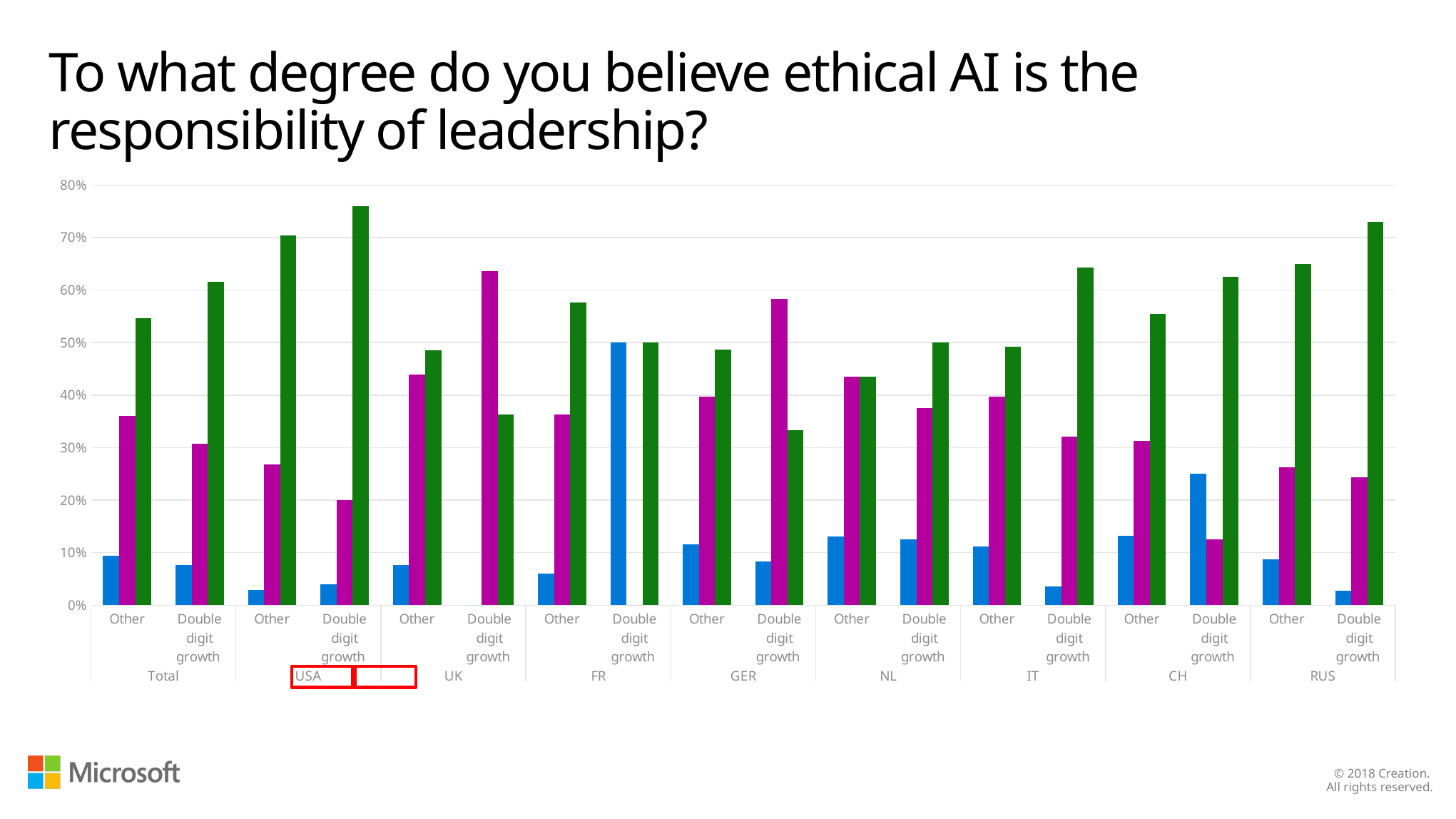
For UK 'Double digit growth', which bar is taller, the magenta bar or the green bar? magenta Is the magenta bar for UK 'Double digit growth' greater or less than 60%? greater Is the green bar for Total 'Other' greater or less than 50%? greater Is the green bar for USA 'Double digit growth' greater or less than 70%? greater What is the highest value shown on the y axis? 80% What kind of chart is shown on the slide? bar chart How many country/region groups are labelled along the x axis (including Total)? 9 Which category has the tallest blue bar? FR Double digit growth How many bars are plotted for each category (e.g. for 'Other' under Total)? 3